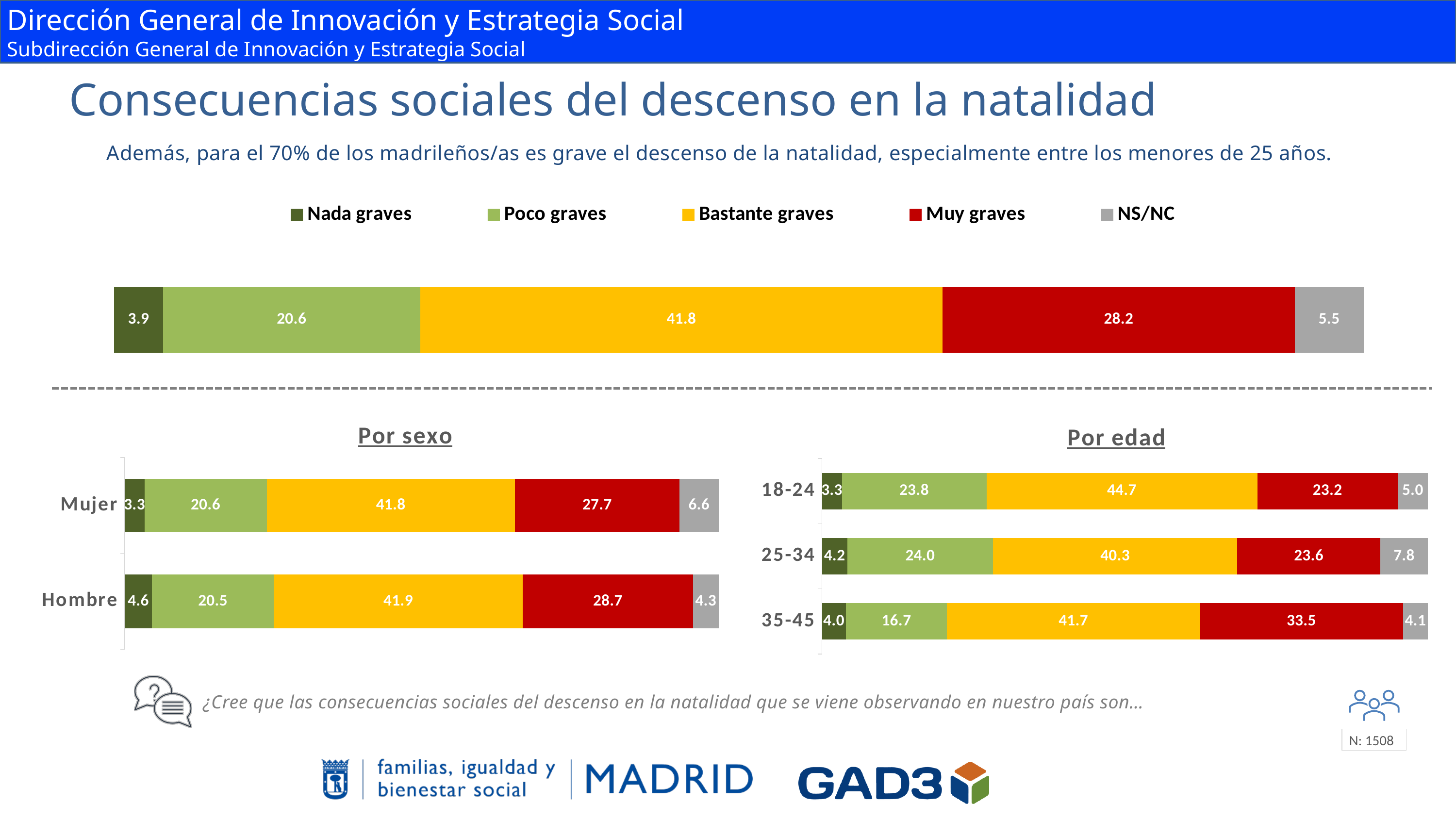
In the Por sexo chart, what is the difference between the Muy graves values for Hombre and Mujer? 1.0 In the Por edad chart, is the NS/NC value larger for 25-34 or for 18-24? 25-34 In the top overall chart, what is the value for Bastante graves? 41.8 In the Por sexo chart, what is the Muy graves value for Hombre? 28.7 In the Por edad chart, which age group has the highest Muy graves value? 35-45 In the top overall chart, which category has the lowest value? Nada graves What kind of chart is the Por edad chart? Stacked bar chart In the Por sexo chart, what is the NS/NC value for Mujer? 6.6 In the top overall chart, what is the value for Muy graves? 28.2 In the Por edad chart, what is the Bastante graves value for 18-24? 44.7 How many series does the legend list? 5 In the Por edad chart, which age group has the lowest Poco graves value? 35-45